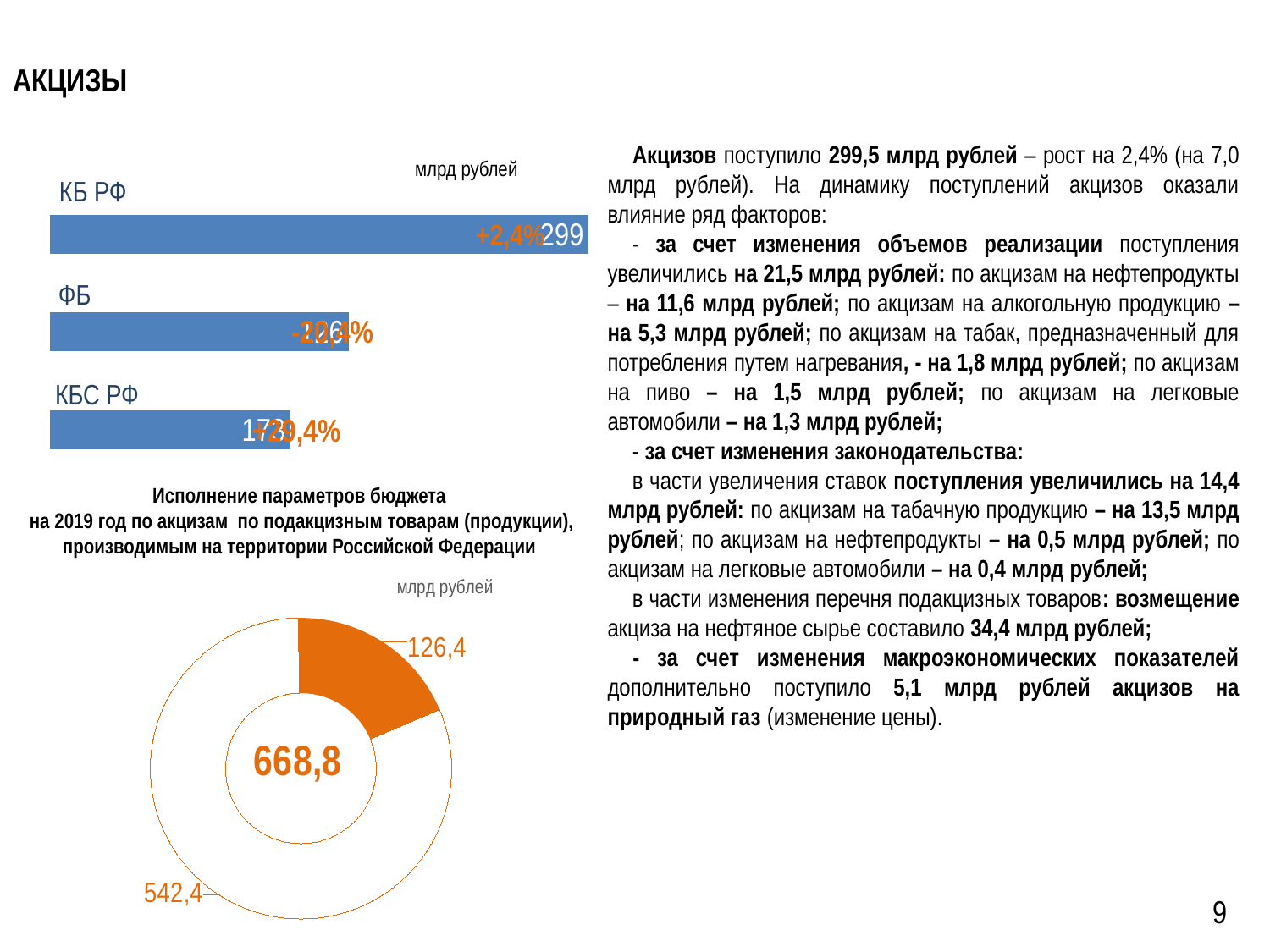
In the bar chart at the top left, what percentage change is shown next to the КБ РФ bar? +2,4% In the doughnut chart at the bottom left, what value is shown for the orange segment? 126,4 In the bar chart at the top left, what unit is indicated above the bars? млрд рублей In the doughnut chart at the bottom left, what is the difference between the segment labelled 542,4 and the segment labelled 126,4? 416,0 What kind of chart is shown at the top left of the slide? bar chart In the bar chart at the top left, how many categories are shown? 3 In the doughnut chart at the bottom left, which segment is larger, the one labelled 126,4 or the one labelled 542,4? 542,4 In the bar chart at the top left, is the bar for КБ РФ longer or shorter than the bar for ФБ? longer What kind of chart is shown at the bottom left of the slide? doughnut chart In the doughnut chart at the bottom left, what value is shown in the centre? 668,8 In the bar chart at the top left, which category has the longest bar? КБ РФ In the bar chart at the top left, what value is shown for КБ РФ? 299